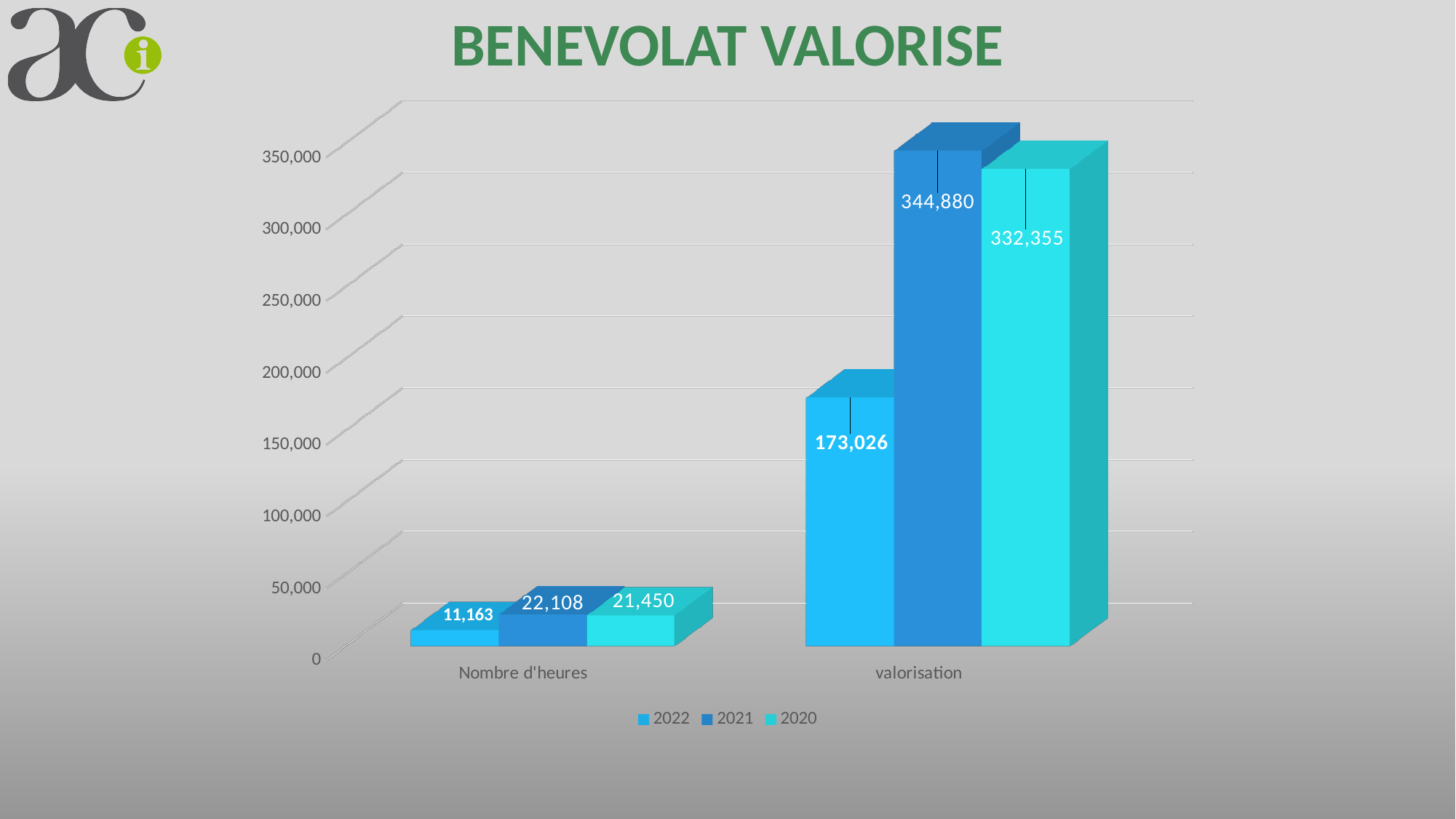
What is the value for 2020 in the Nombre d'heures category? 21,450 Which year has the highest value in the valorisation category? 2021 What is the value for 2020 in the valorisation category? 332,355 Which year has the lowest value in the Nombre d'heures category? 2022 What is the title of the chart? BENEVOLAT VALORISE What is the value for 2021 in the valorisation category? 344,880 What is the difference between the 2021 and 2020 values in the valorisation category? 12,525 What is the value for 2022 in the Nombre d'heures category? 11,163 What kind of chart is shown on the slide? Bar chart What is the difference between the 2021 and 2022 values in the Nombre d'heures category? 10,945 How many series does the legend list? 3 Which is larger in the valorisation category, the 2022 value or the 2020 value? 2020